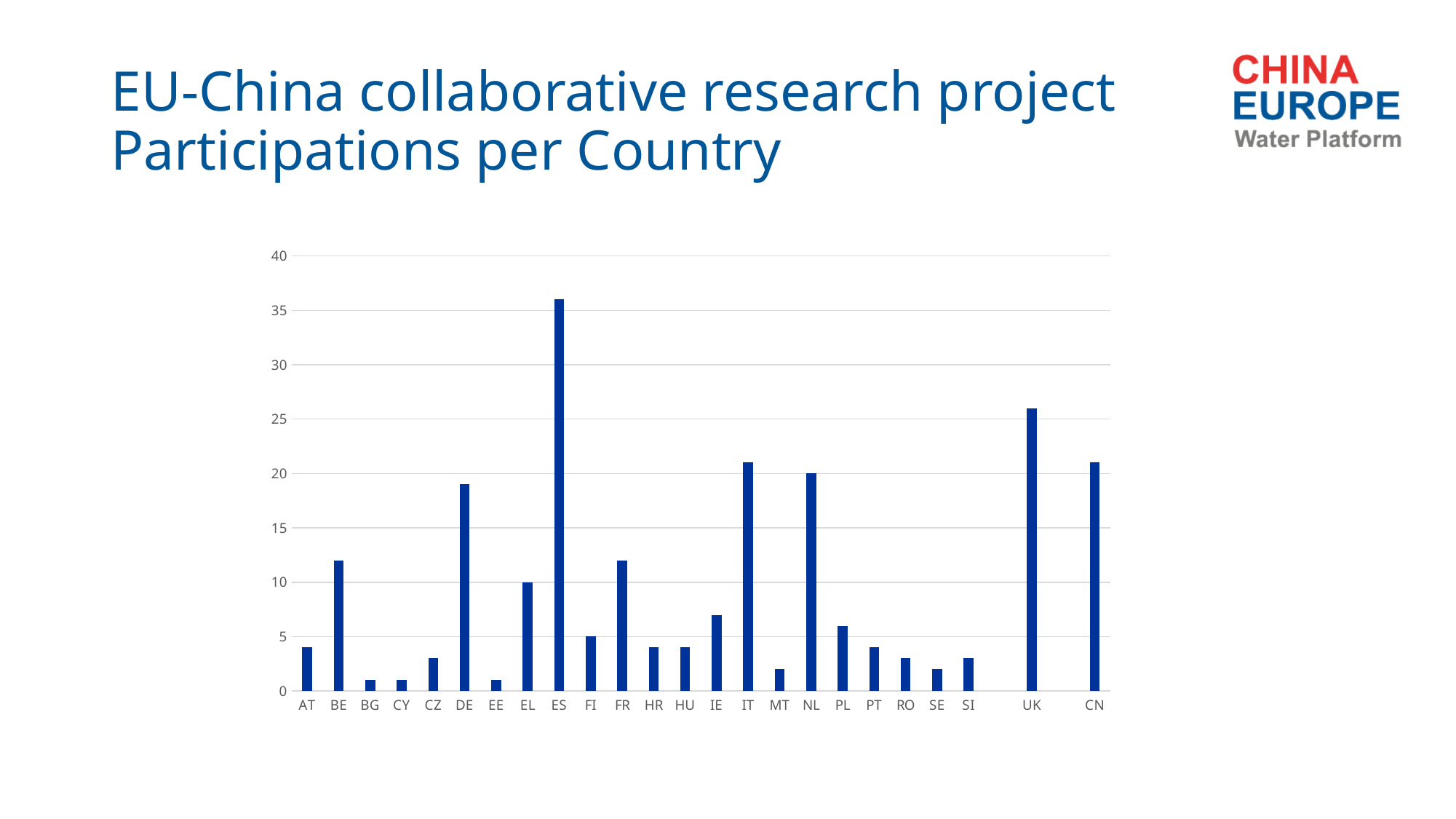
Is the value for BE greater or less than 10? greater Which has more participations, ES or UK? ES Is the value for ES greater or less than 35? greater What is the value for FI? 5 What is the value for NL? 20 Is the value for DE greater or less than 20? less What is the value for EL? 10 What kind of chart is shown on the slide? bar chart Which country has the highest number of participations? ES What is the title of the slide containing the chart? EU-China collaborative research project Participations per Country Which has more participations, DE or IT? IT